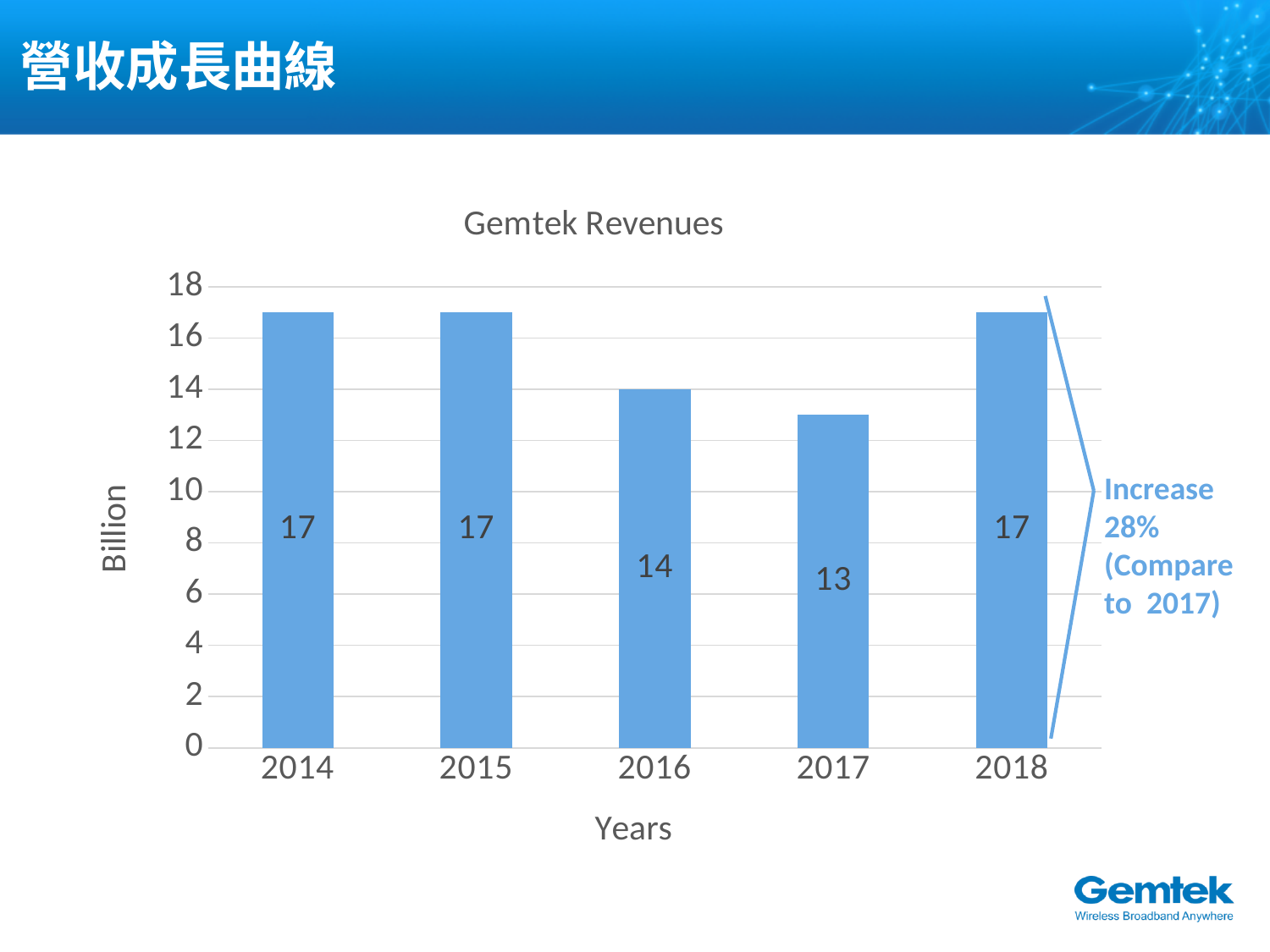
What is the revenue value for 2018? 17 Which year has the lowest revenue? 2017 What is the title of the chart? Gemtek Revenues What kind of chart is shown on the slide? bar chart Which is larger, the revenue for 2016 or the revenue for 2017? 2016 Is the value for 2017 greater or less than 14? less How many years are shown on the x axis? 5 What is the difference between the revenue in 2018 and the revenue in 2017? 4 Do the revenue values rise or fall from 2015 to 2017? fall What is the revenue value for 2016? 14 What is the difference between the revenue in 2015 and the revenue in 2016? 3 What is the revenue value for 2017? 13